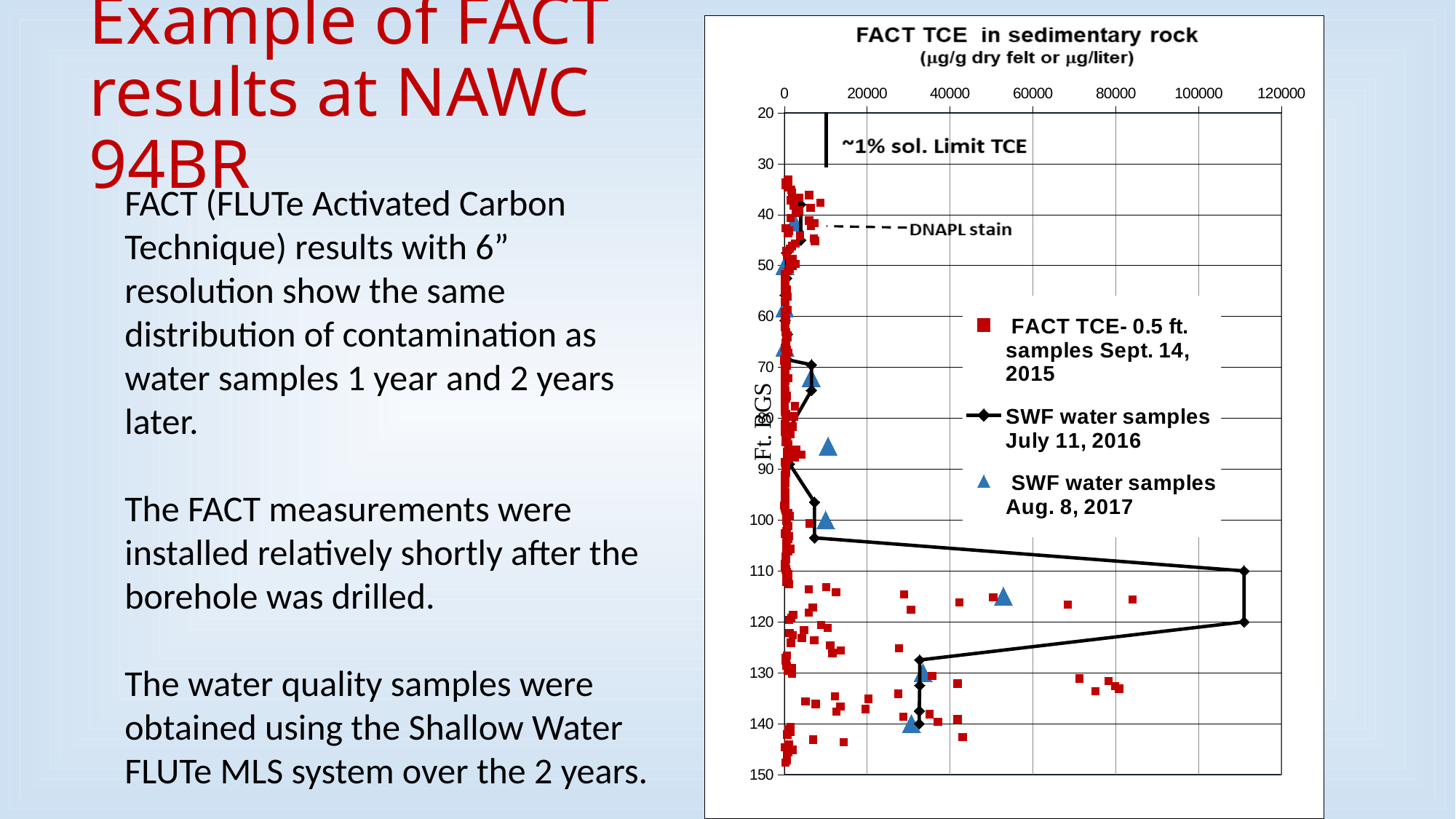
How many series does the chart's legend list? 3 What is the title of the chart? FACT TCE in sedimentary rock Which is larger: the SWF water samples Aug. 8, 2017 value at about 115 ft or at about 140 ft? at about 115 ft What is the label of the vertical axis of the chart? Ft. BGS Is the SWF water samples July 11, 2016 value at a depth of 110 ft greater or less than 100000? greater Is the SWF water samples Aug. 8, 2017 value at a depth of about 115 ft greater or less than 40000? greater Is the SWF water samples Aug. 8, 2017 value at a depth of about 85 ft greater or less than 20000? less Which series in the chart is plotted with red square markers? FACT TCE- 0.5 ft. samples Sept. 14, 2015 What kind of chart is shown on the slide? scatter chart Which is larger: the SWF water samples July 11, 2016 value at 110 ft or the SWF water samples Aug. 8, 2017 value at about 115 ft? SWF water samples July 11, 2016 at 110 ft